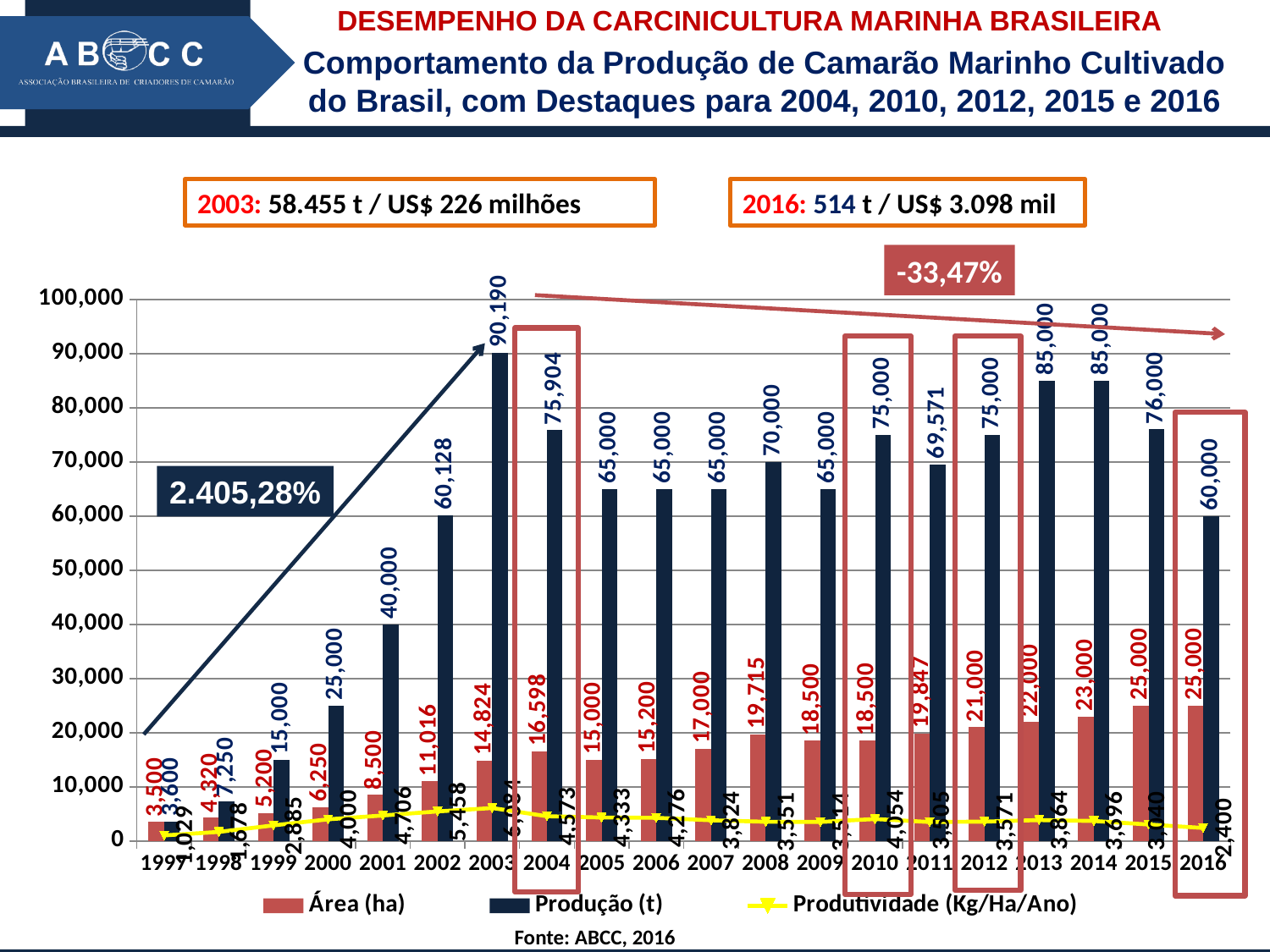
How many series does the legend list? 3 How many years are shown on the x axis? 20 What kind of chart is shown on the slide? A combined bar and line chart What source is cited below the chart? Fonte: ABCC, 2016 What is the Produtividade (Kg/Ha/Ano) value for 2016? 2,400 Which year has the highest Produção (t)? 2003 What is the difference between the Produção (t) values for 2003 and 2016? 30,190 Does the Produção (t) rise or fall from 1997 to 2003? Rises Which year has the larger Produção (t), 2013 or 2015? 2013 What is the Área (ha) value for 2016? 25,000 Which year has the lowest Produção (t)? 1997 What is the Produção (t) value for 2003? 90,190